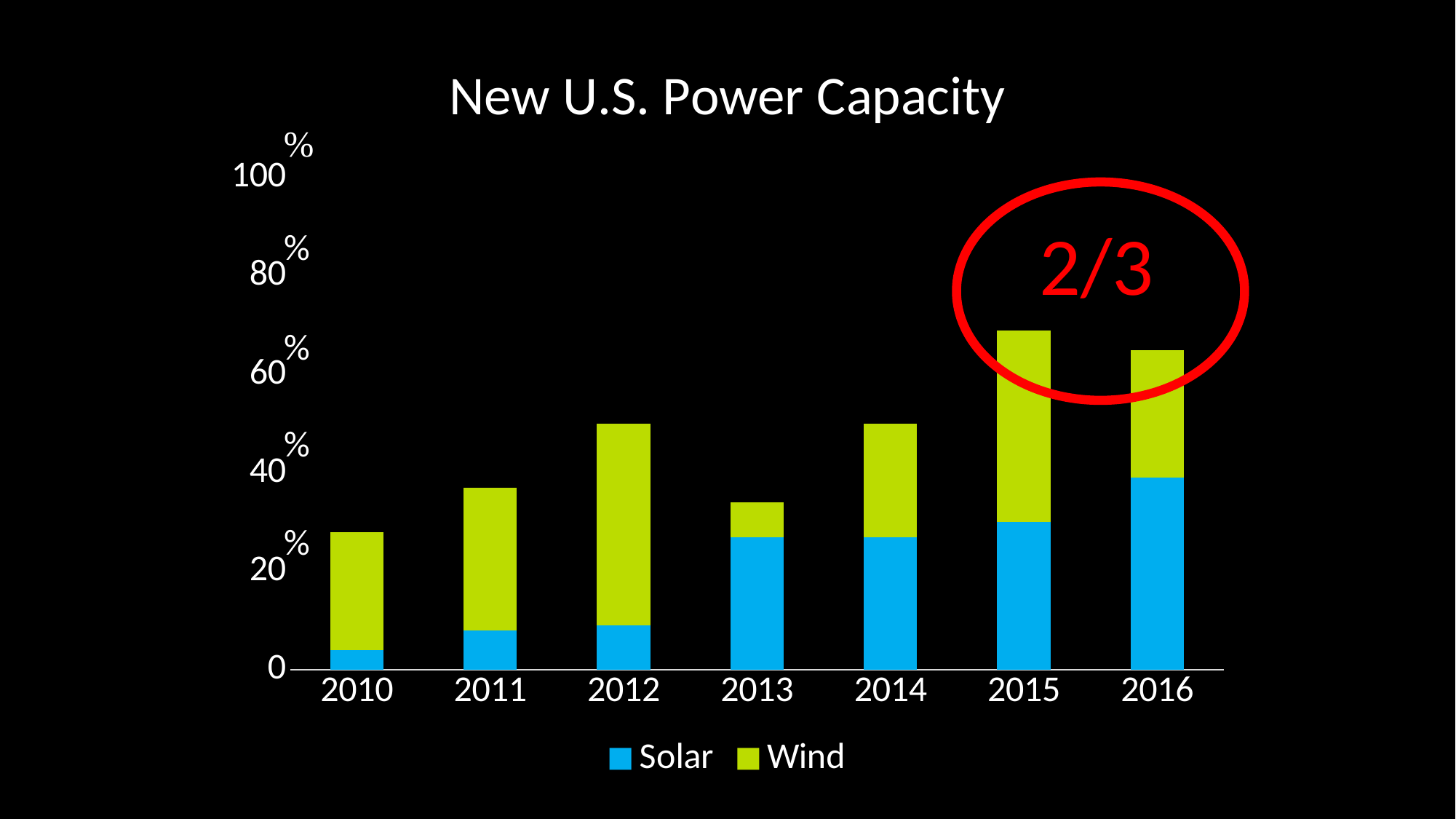
What is the title of the chart? New U.S. Power Capacity How many years are shown on the x axis? 7 Which colour represents Solar in the chart? Blue How many series does the legend list? 2 Is the total bar for 2013 greater or less than 40%? less Which year has the highest total bar? 2015 Which is larger, the Solar value for 2010 or the Solar value for 2016? 2016 Which is larger, the Wind value for 2012 or the Wind value for 2013? 2012 Which year has the lowest total bar? 2010 Is the Solar value for 2016 greater or less than 20%? greater What kind of chart is shown on the slide? Stacked bar chart Is the total bar for 2015 greater or less than 60%? greater